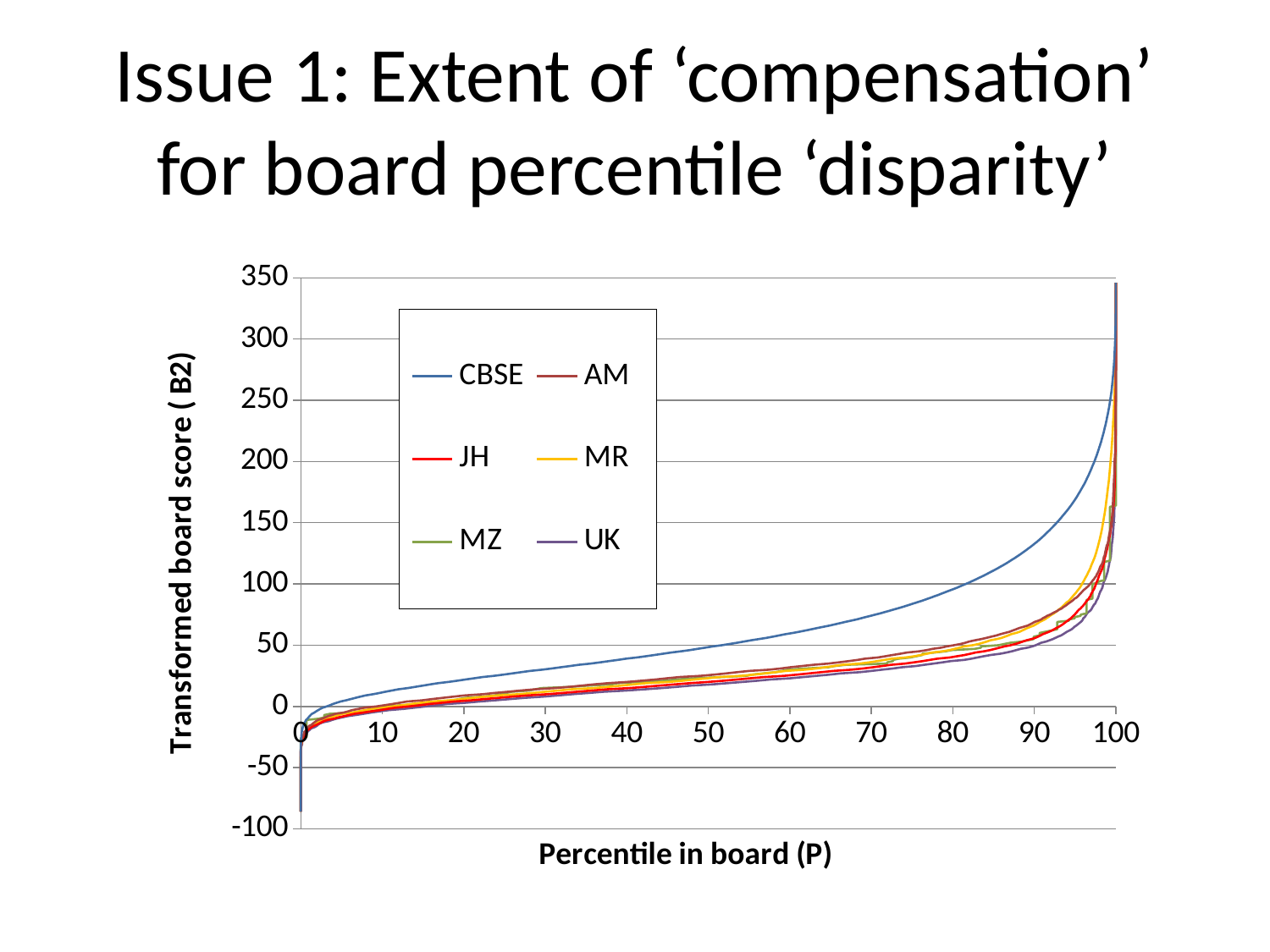
Do the transformed board scores rise or fall as the percentile in board increases? rise What kind of chart is shown on the slide? line chart Is the transformed board score for UK at a percentile of 80 greater or less than 50? less How many series does the legend list? 6 Which series has the highest transformed board score at a percentile of 50? CBSE Is the transformed board score for CBSE at a percentile of 70 greater or less than 50? greater Is the transformed board score for CBSE at a percentile of 90 greater or less than 100? greater Which series are listed in the chart legend? CBSE, AM, JH, MR, MZ, UK Which series has the lowest transformed board score at a percentile of 80? UK What is the title of the x axis? Percentile in board (P) At a percentile of 70, which series has the larger transformed board score, CBSE or UK? CBSE